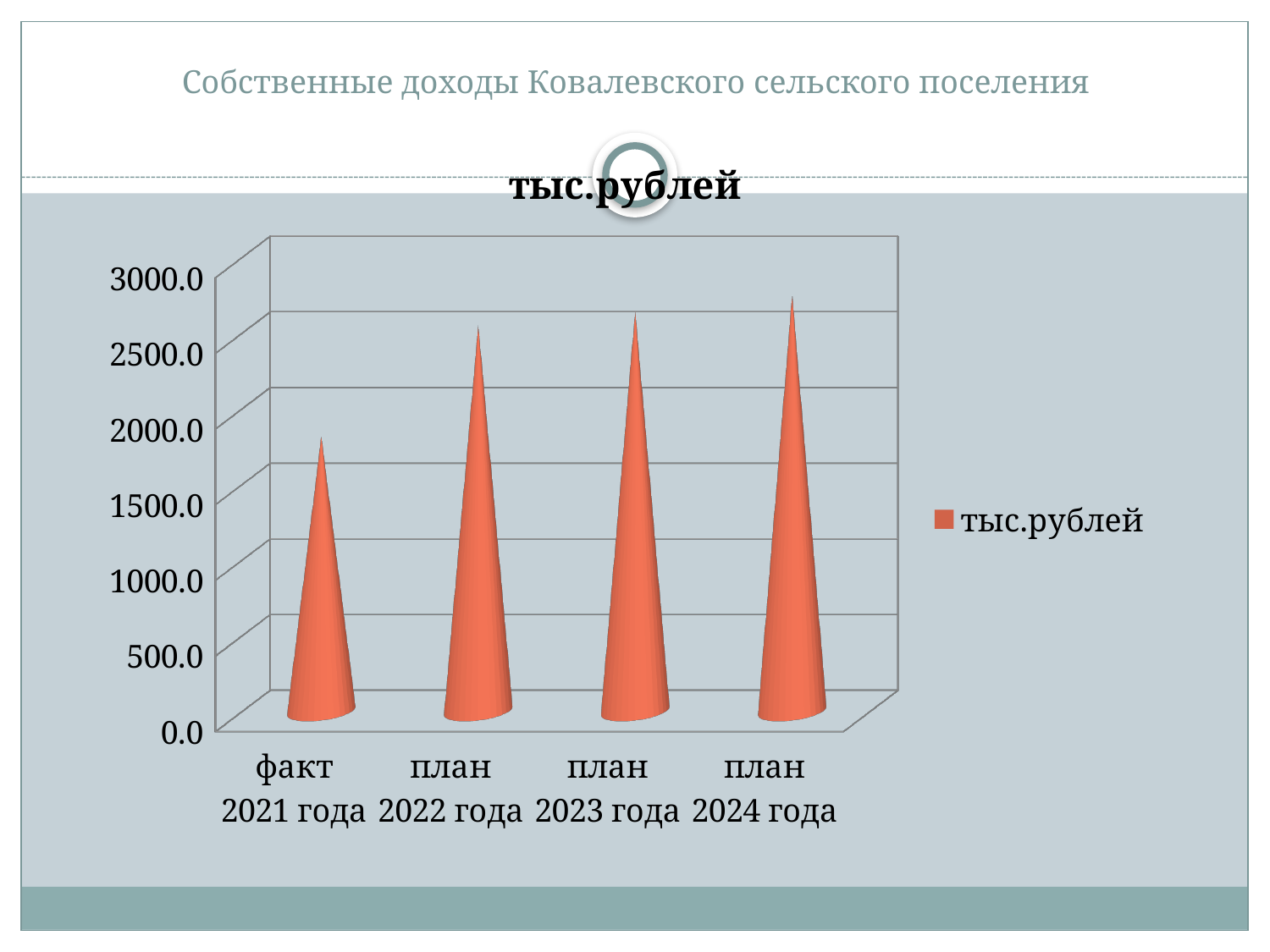
Do the values rise or fall from факт 2021 года to план 2024 года? Rise What is the name of the series listed in the chart legend? тыс.рублей What kind of chart is shown on the slide? Bar chart Which is larger, the value for факт 2021 года or the value for план 2022 года? план 2022 года Is the value for план 2022 года greater or less than 2000? greater Is the value for план 2024 года greater or less than 2500? greater How many categories are shown on the x axis of the chart? 4 What is the title of the chart? тыс.рублей How many series does the chart legend list? 1 Which category has the highest value in the chart? план 2024 года Which category has the lowest value in the chart? факт 2021 года Is the value for факт 2021 года greater or less than 1500? greater